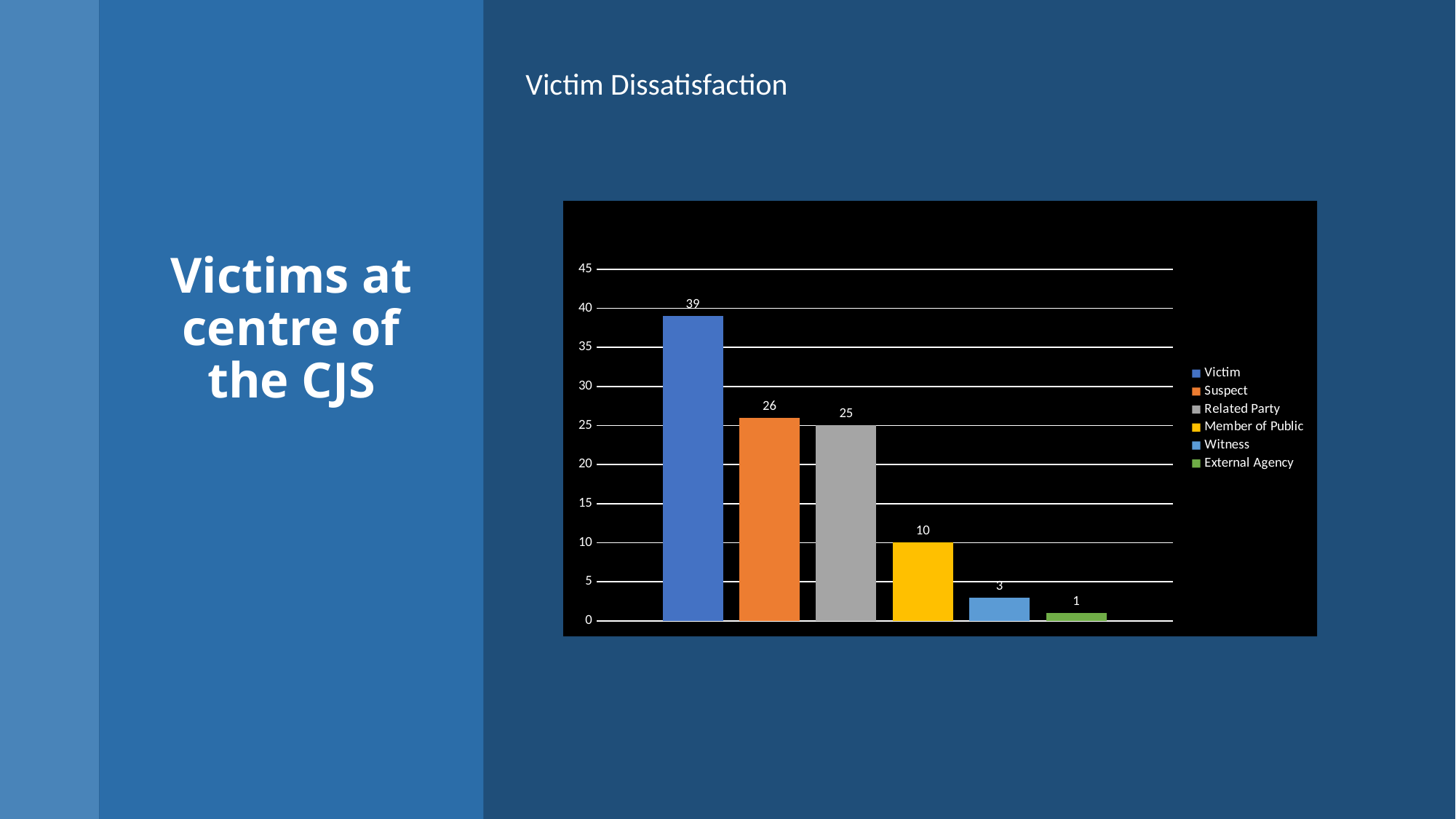
What is the value for Victim? 39 Which category has the highest value? Victim How many categories are shown in the chart? 6 What is the value for Member of Public? 10 Is the value for Witness greater or less than 5? less Which is larger, the value for Related Party or the value for Member of Public? Related Party What is the title of the chart? Victim Dissatisfaction What is the difference between the values for Victim and Suspect? 13 Which category has the lowest value? External Agency What is the value for Suspect? 26 What is the value for External Agency? 1 What kind of chart is shown on the slide? Bar chart